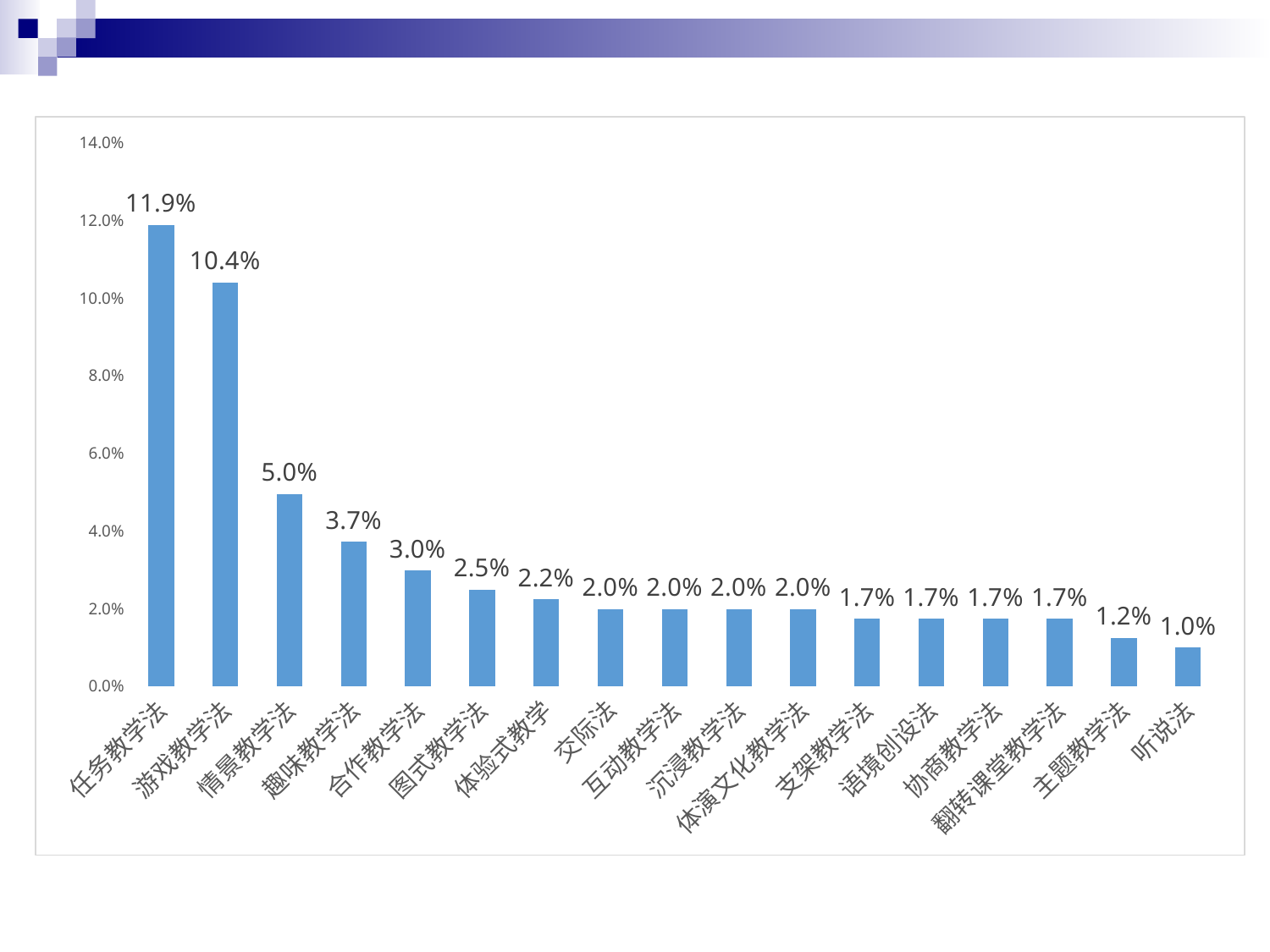
Do the values rise or fall from left to right along the x axis? fall What kind of chart is shown on the slide? bar chart What is the value for 任务教学法? 11.9% Which is larger, the value for 趣味教学法 or the value for 合作教学法? 趣味教学法 What is the value for 听说法? 1.0% How many categories are shown on the x axis? 17 Which category has the lowest value? 听说法 What is the difference between the values for 任务教学法 and 游戏教学法? 1.5% What is the value for 情景教学法? 5.0% Is the value for 情景教学法 greater or less than 4.0%? greater Which category has the highest value? 任务教学法 What is the value for 游戏教学法? 10.4%